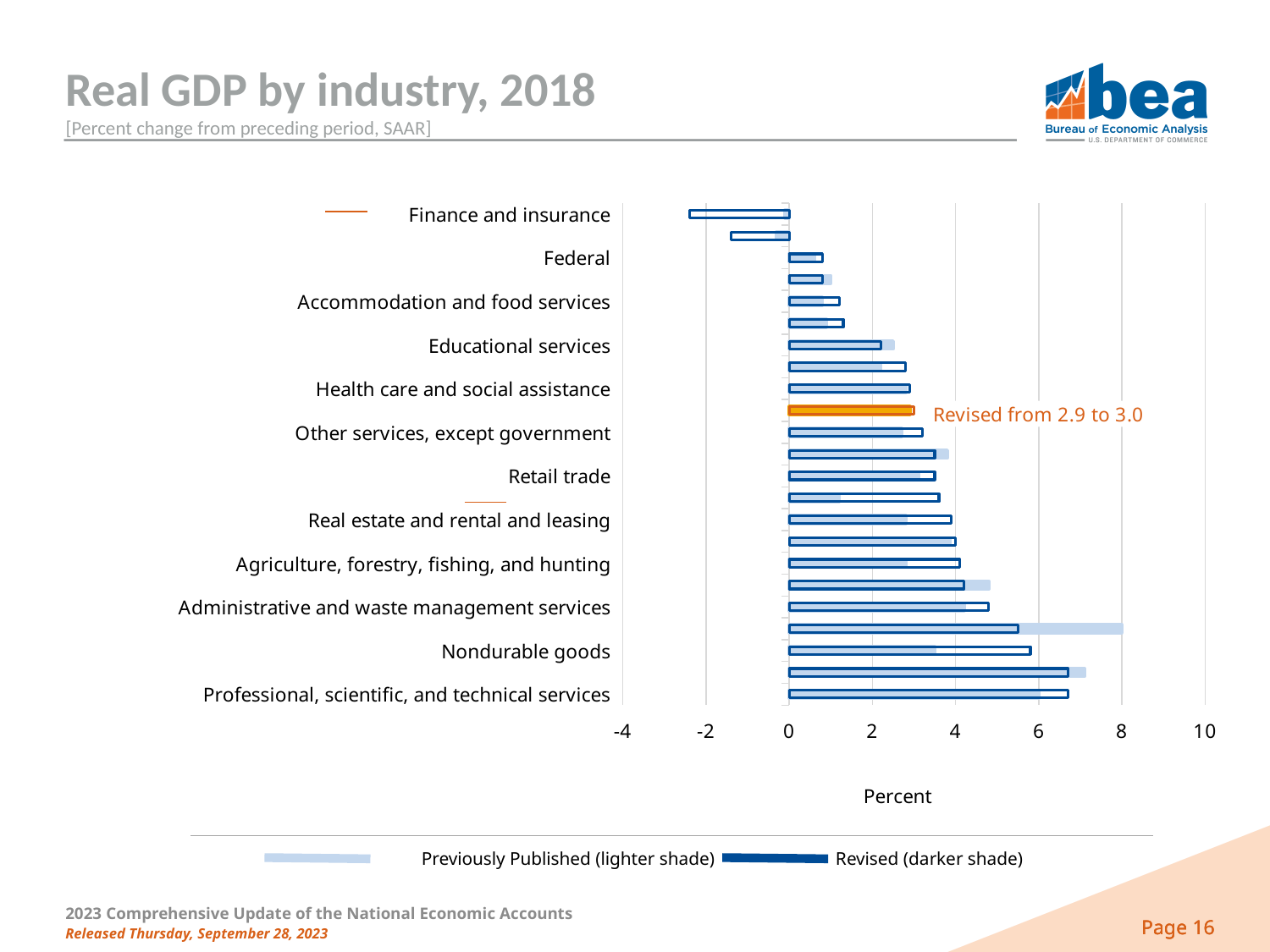
Is the revised value for Nondurable goods greater or less than 4? greater Is the revised value for Health care and social assistance greater or less than 4? less How many industry labels are listed on the vertical axis? 12 Which has the larger revised value, Nondurable goods or Federal? Nondurable goods Is the revised value for Finance and insurance greater or less than 0? less Which labeled industry has the lowest value? Finance and insurance What kind of chart is shown on the slide? bar chart How many series does the legend list? 2 What does the annotation next to the orange bar say? Revised from 2.9 to 3.0 What is the title of the chart? Real GDP by industry, 2018